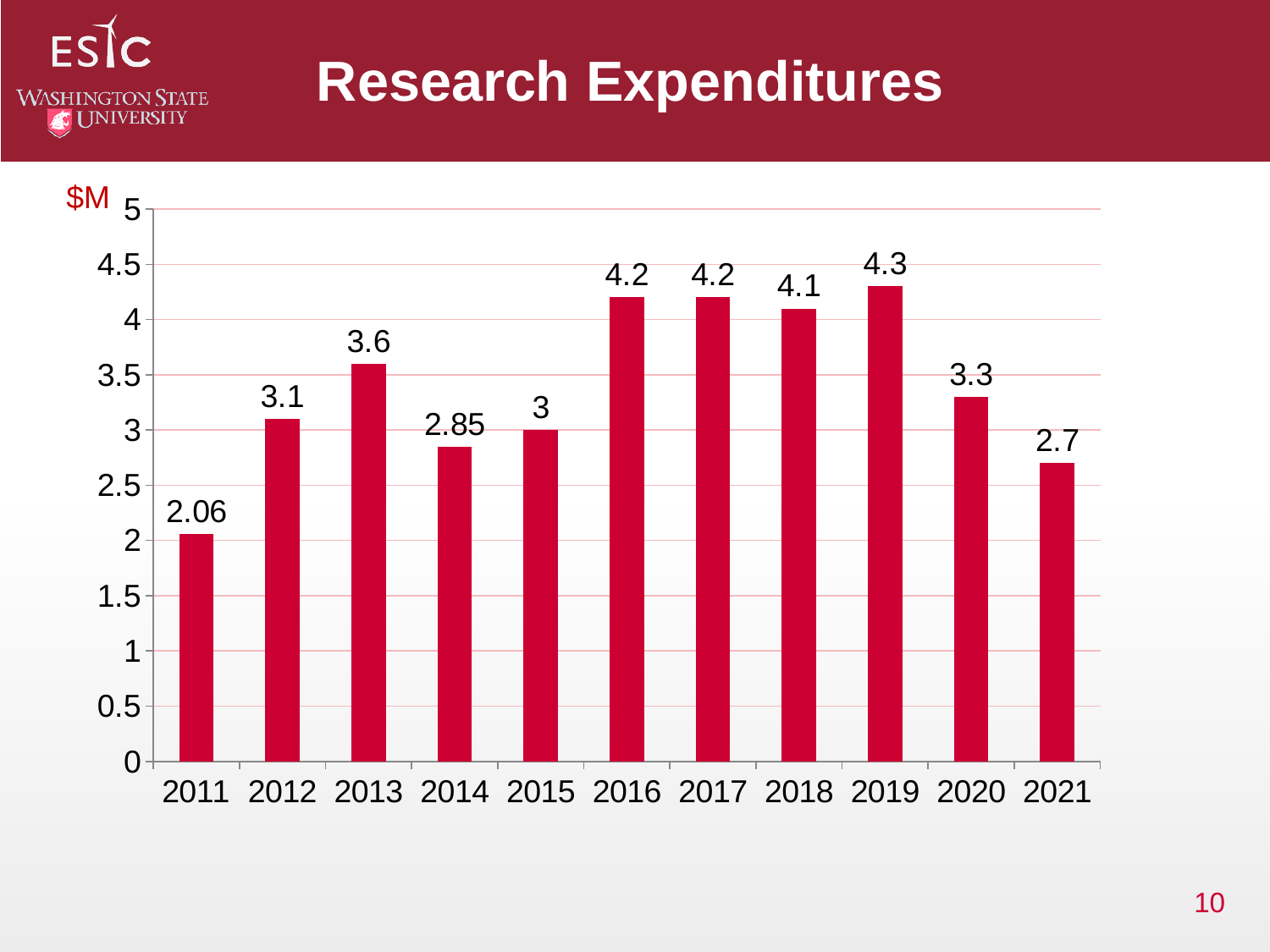
Which year has a larger value, 2015 or 2018? 2018 Is the value for 2016 greater or less than 4? greater What is the research expenditure value for 2014? 2.85 What is the research expenditure value for 2011? 2.06 How many years are shown on the x axis? 11 What kind of chart is shown on the slide? Bar chart What is the difference between the values for 2013 and 2012? 0.5 What unit label is shown at the top of the y axis? $M Which year has the lowest research expenditure? 2011 What is the research expenditure value for 2021? 2.7 What is the difference between the values for 2019 and 2020? 1 Which year has the highest research expenditure? 2019